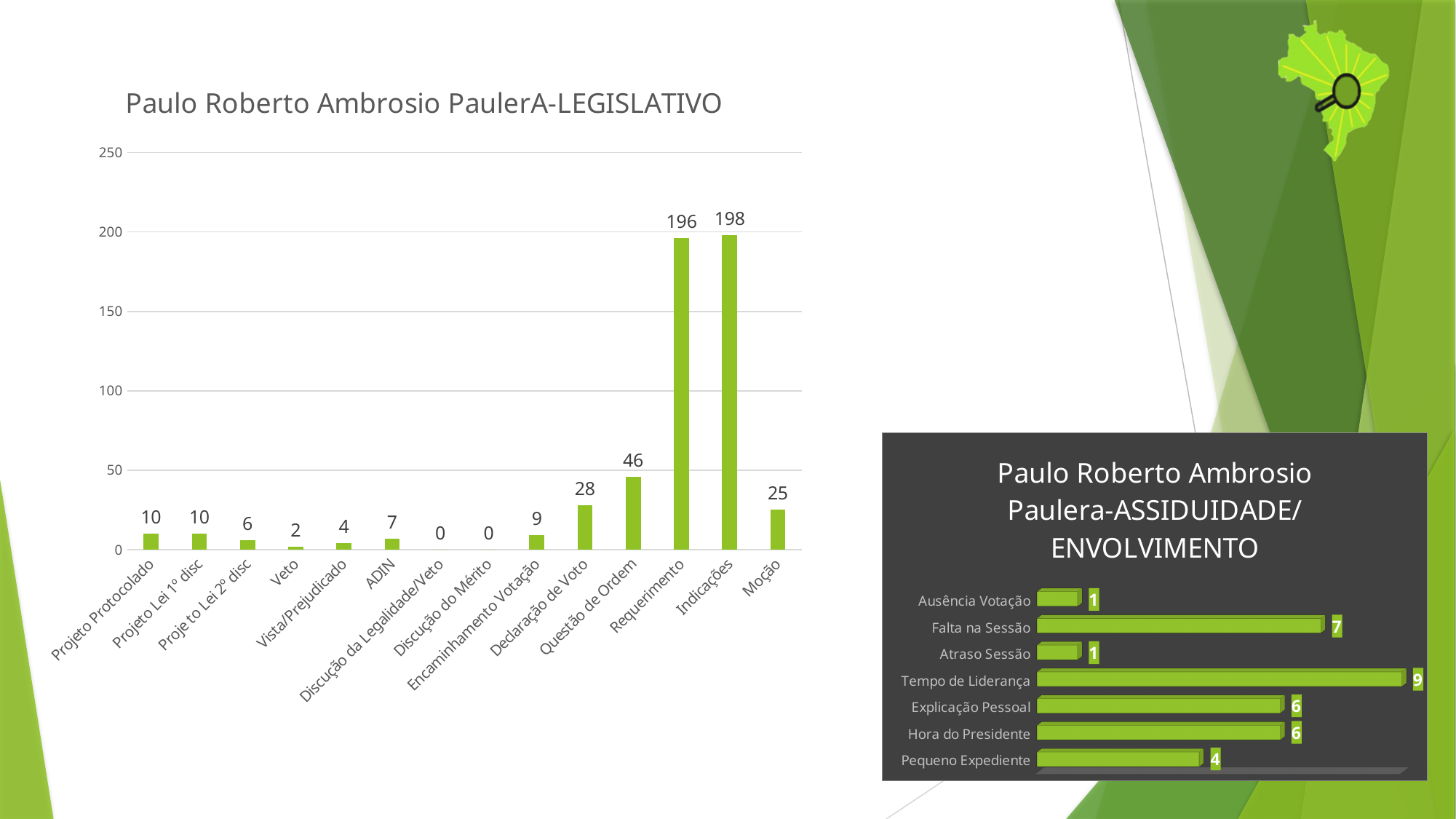
In the LEGISLATIVO chart, what is the difference between Indicações and Requerimento? 2 In the LEGISLATIVO chart, what is the value for Declaração de Voto? 28 In the ASSIDUIDADE/ENVOLVIMENTO chart, what is the value for Falta na Sessão? 7 In the LEGISLATIVO chart, which is larger, Questão de Ordem or Moção? Questão de Ordem In the LEGISLATIVO chart, what is the value for Requerimento? 196 In the LEGISLATIVO chart, how many categories are shown on the x axis? 14 In the LEGISLATIVO chart, which category has the highest value? Indicações In the ASSIDUIDADE/ENVOLVIMENTO chart, what is the difference between Tempo de Liderança and Pequeno Expediente? 5 In the LEGISLATIVO chart, is the value for Requerimento greater or less than 150? greater In the ASSIDUIDADE/ENVOLVIMENTO chart, which category has the highest value? Tempo de Liderança In the ASSIDUIDADE/ENVOLVIMENTO chart, how many categories are shown? 7 What kind of chart is the ASSIDUIDADE/ENVOLVIMENTO chart? bar chart